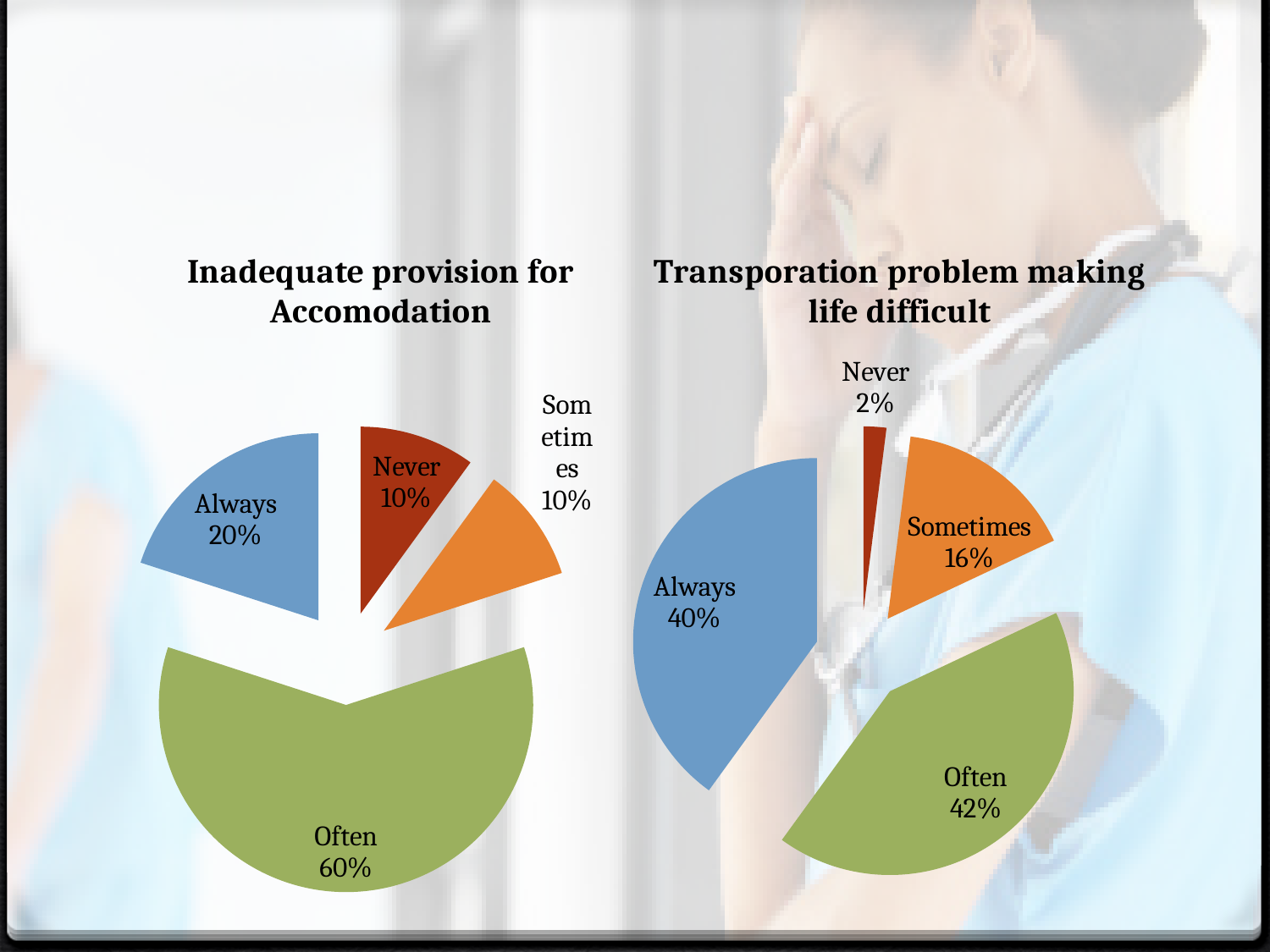
In the 'Transporation problem making life difficult' chart, what percentage is shown for Sometimes? 16% In the 'Inadequate provision for Accomodation' chart, what is the difference in percentage points between Often and Always? 40 How many slices does the 'Transporation problem making life difficult' chart have? 4 In the 'Transporation problem making life difficult' chart, what is the difference in percentage points between Often and Always? 2 In the 'Inadequate provision for Accomodation' chart, what percentage is shown for Often? 60% What type of chart is the 'Inadequate provision for Accomodation' chart? Pie chart In the 'Transporation problem making life difficult' chart, which category has the smallest slice? Never In the 'Inadequate provision for Accomodation' chart, which category has the largest slice? Often In the 'Inadequate provision for Accomodation' chart, what percentage is shown for Always? 20% In the 'Transporation problem making life difficult' chart, what colour is the Often slice? Green In the 'Transporation problem making life difficult' chart, what percentage is shown for Never? 2% In the 'Inadequate provision for Accomodation' chart, which is larger, Always or Never? Always